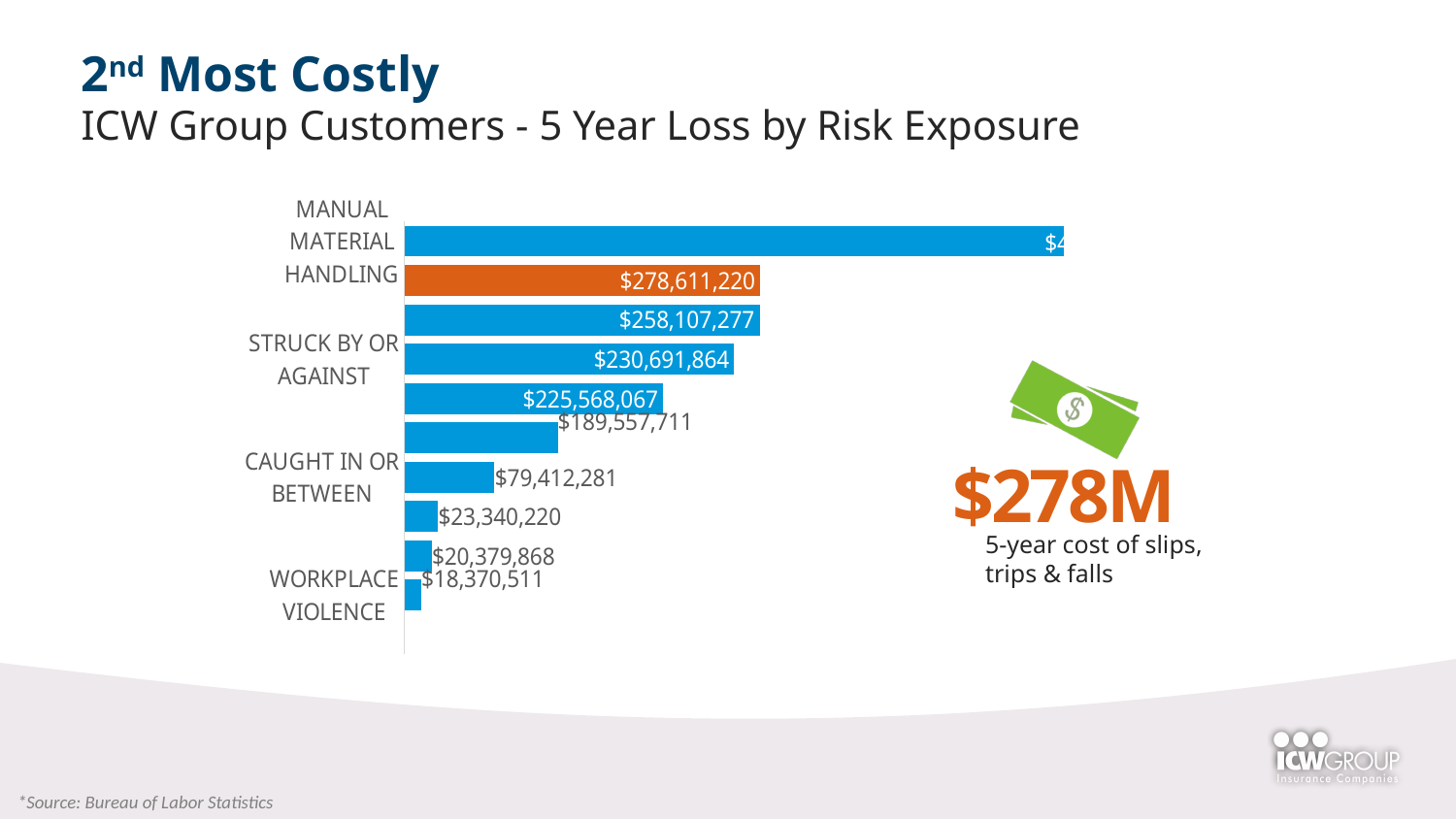
What is the subtitle describing the chart on the slide? ICW Group Customers - 5 Year Loss by Risk Exposure What is the value shown on the orange bar? $278,611,220 Which is larger, the bar labeled $79,412,281 or the bar labeled $23,340,220? $79,412,281 What is the difference between the $23,340,220 bar and the $20,379,868 bar? $2,960,352 What colour is the highlighted bar that differs from the others? Orange Which category has the longest bar in the chart? MANUAL MATERIAL HANDLING Do the bar values increase or decrease going from the top of the chart to the bottom? Decrease What is the value of the bar for WORKPLACE VIOLENCE? $18,370,511 What is the value of the shortest bar in the chart? $18,370,511 How many bars are plotted in the chart? 10 What is the difference between the $278,611,220 bar and the $258,107,277 bar? $20,503,943 What kind of chart is shown on the slide? Bar chart